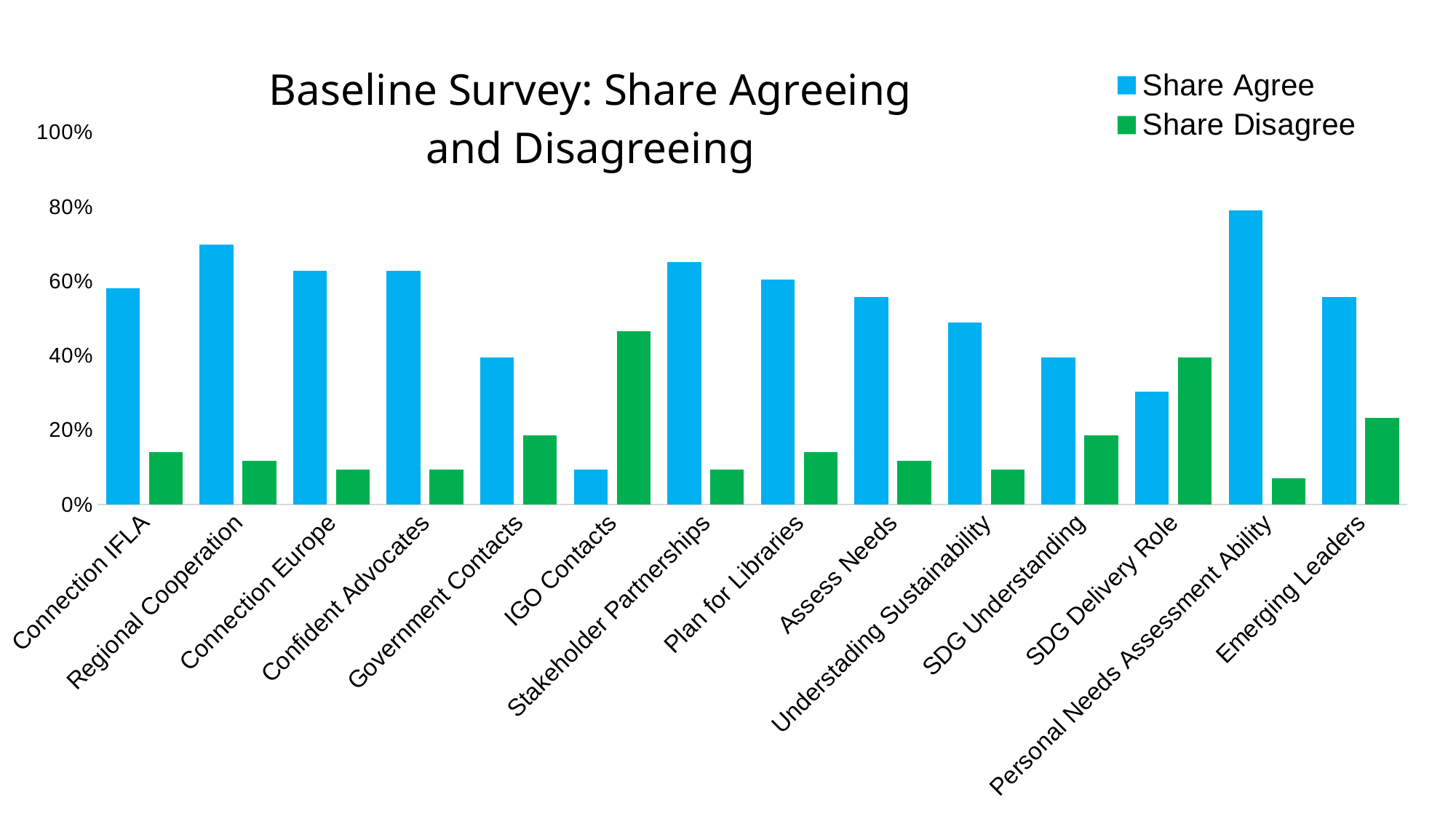
Which is larger: the Share Agree value for Regional Cooperation or for Connection IFLA? Regional Cooperation Is the Share Agree value for Regional Cooperation greater or less than 60%? greater How many categories are shown on the x axis? 14 Which category has the highest Share Agree value? Personal Needs Assessment Ability Is the Share Agree value for IGO Contacts greater or less than 20%? less How many series does the legend list? 2 What is the title of the chart? Baseline Survey: Share Agreeing and Disagreeing For IGO Contacts, which is larger: Share Agree or Share Disagree? Share Disagree What kind of chart is shown on the slide? Bar chart Which category has the lowest Share Agree value? IGO Contacts Which category has the highest Share Disagree value? IGO Contacts Is the Share Disagree value for SDG Delivery Role greater or less than 20%? greater